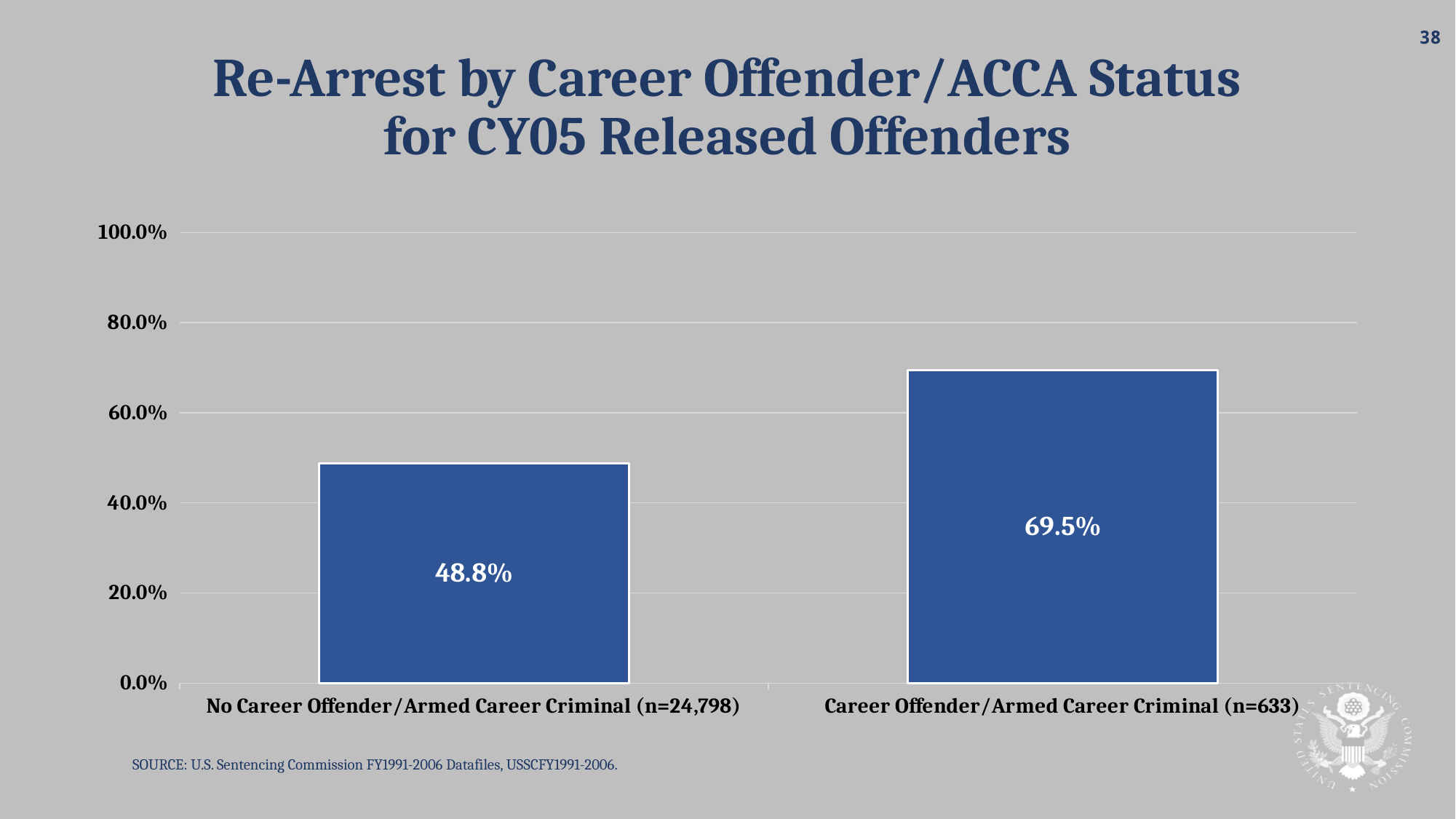
Is the value for No Career Offender/Armed Career Criminal greater or less than 60.0%? less What is the re-arrest rate for Career Offender/Armed Career Criminal (n=633)? 69.5% Which category has the lowest re-arrest rate? No Career Offender/Armed Career Criminal (n=24,798) How many categories are shown on the x axis? 2 What is the maximum value shown on the y axis? 100.0% Which category has the highest re-arrest rate? Career Offender/Armed Career Criminal (n=633) Is the value for Career Offender/Armed Career Criminal greater or less than 60.0%? greater Which is larger: the re-arrest rate for Career Offender/Armed Career Criminal or for No Career Offender/Armed Career Criminal? Career Offender/Armed Career Criminal What is the title of the chart? Re-Arrest by Career Offender/ACCA Status for CY05 Released Offenders What is the difference in percentage points between the Career Offender/Armed Career Criminal rate and the No Career Offender/Armed Career Criminal rate? 20.7 percentage points What is the re-arrest rate for No Career Offender/Armed Career Criminal (n=24,798)? 48.8% What kind of chart is shown on the slide? Bar chart